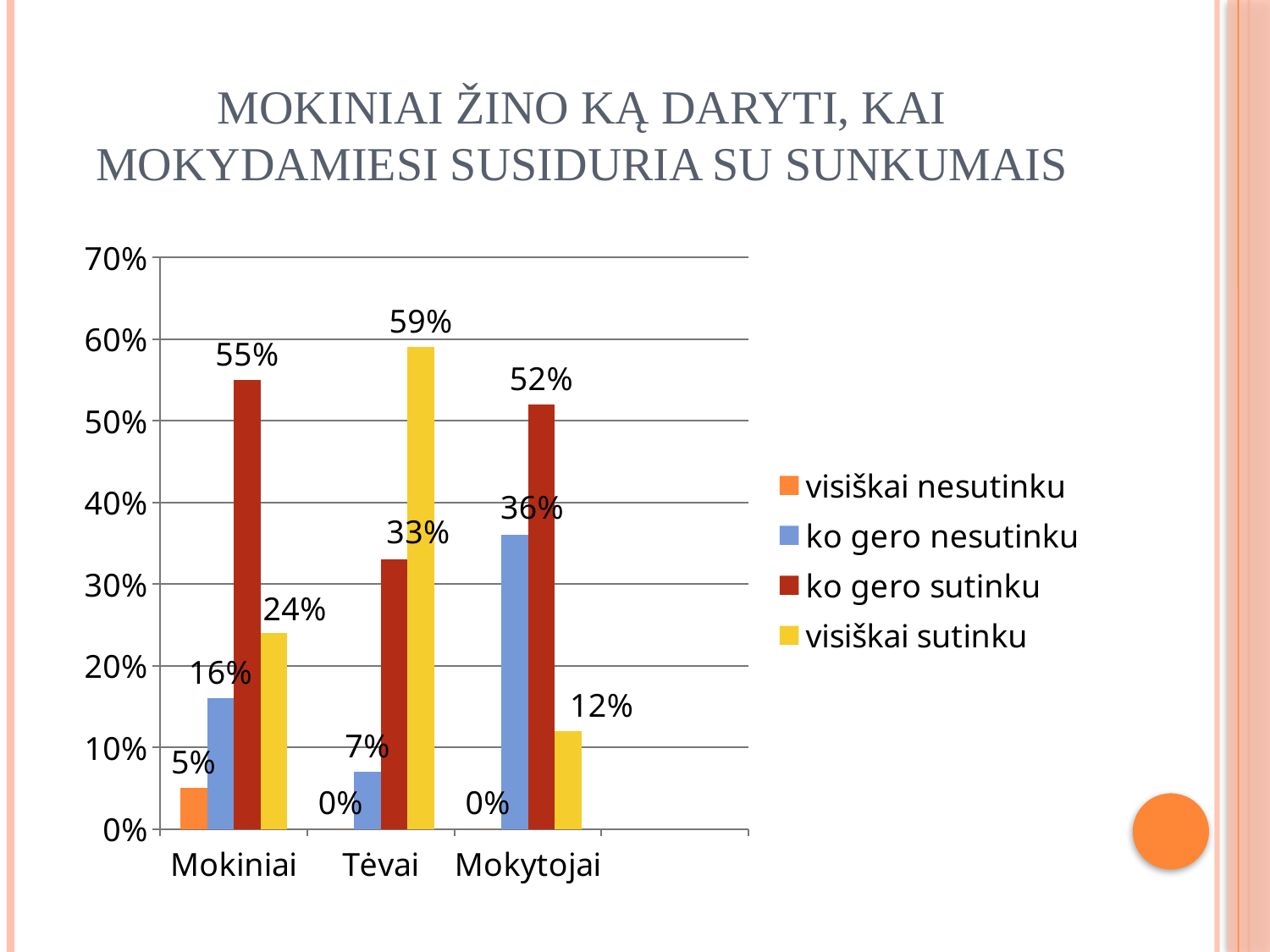
What is the difference between "ko gero sutinku" for Mokiniai and for Tėvai? 22% What kind of chart is shown on the slide? Bar chart Which is larger: "visiškai sutinku" for Mokiniai or for Mokytojai? Mokiniai How many series does the legend list? 4 Which category has the highest value for "visiškai sutinku"? Tėvai What is the value of "visiškai nesutinku" for Mokiniai? 5% What is the value of "ko gero sutinku" for Mokiniai? 55% How many categories are shown on the x axis? 3 What is the value of "ko gero nesutinku" for Mokytojai? 36% Which category has the lowest value for "ko gero nesutinku"? Tėvai Which colour represents "ko gero sutinku" in the legend? Dark red What is the value of "visiškai sutinku" for Tėvai? 59%